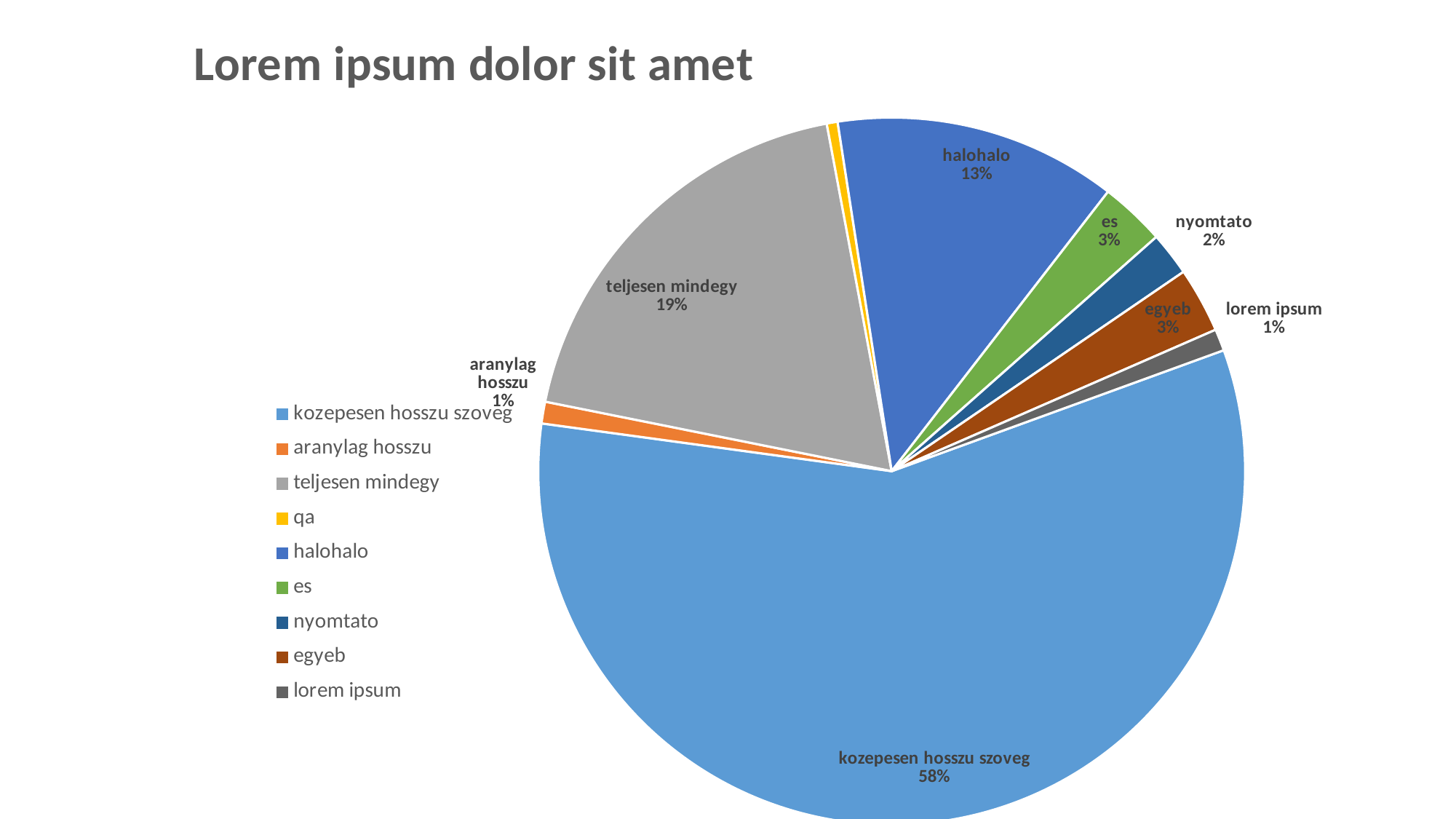
What kind of chart is shown on the slide? pie chart What is the value shown for nyomtato? 2% What is the difference between the shares of kozepesen hosszu szoveg and teljesen mindegy? 39% What is the value shown for egyeb? 3% Which is larger, the slice for teljesen mindegy or the slice for halohalo? teljesen mindegy What share of the pie does teljesen mindegy have? 19% What is the difference between the shares of halohalo and es? 10% What is the title of the chart? Lorem ipsum dolor sit amet Which category has the largest slice of the pie? kozepesen hosszu szoveg What is the value shown for halohalo? 13% What share of the pie does kozepesen hosszu szoveg have? 58% How many categories does the legend list? 9